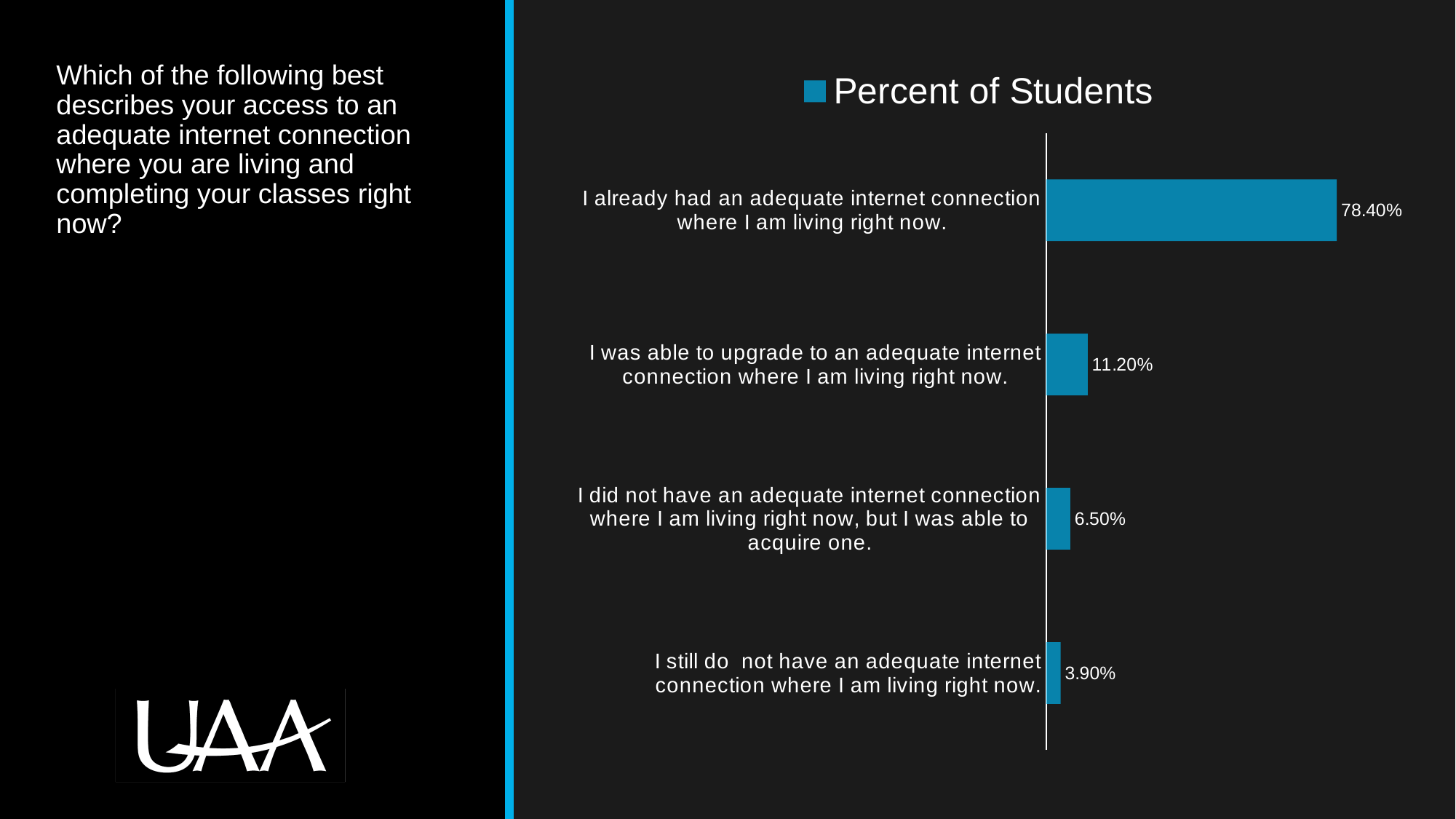
What percent of students said they did not have an adequate internet connection but were able to acquire one? 6.50% Which response category has the highest percent of students? I already had an adequate internet connection where I am living right now. Which is larger: the percent who were able to upgrade or the percent who still do not have an adequate connection? I was able to upgrade to an adequate internet connection where I am living right now. What percent of students said they still do not have an adequate internet connection where they are living right now? 3.90% Which response category has the lowest percent of students? I still do not have an adequate internet connection where I am living right now. What is the difference between the percent who were able to acquire a connection and the percent who still do not have one? 2.60% How many response categories are shown in the chart? 4 What percent of students said they already had an adequate internet connection where they are living right now? 78.40% How many series does the legend list? 1 What kind of chart is shown on the slide? Bar chart What is the difference in percentage points between students who already had an adequate connection and those who were able to upgrade? 67.20% What percent of students said they were able to upgrade to an adequate internet connection where they are living right now? 11.20%